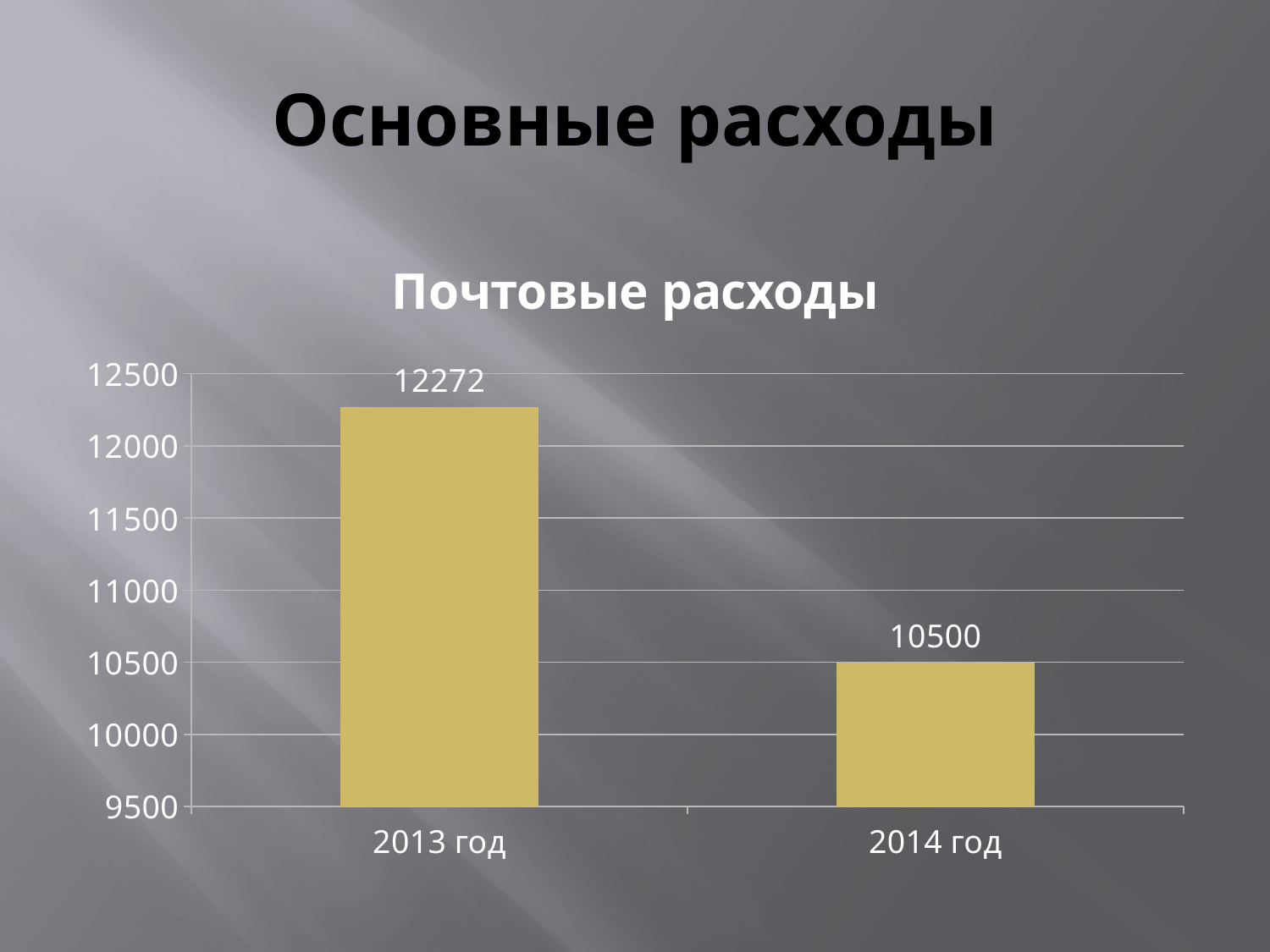
Which is larger, the value for 2013 год or for 2014 год? 2013 год How many categories are shown on the x axis? 2 Is the value for 2014 год greater or less than 11000? less What kind of chart is shown? bar chart Is the value for 2013 год greater or less than 12000? greater What is the value for 2013 год? 12272 What is the value for 2014 год? 10500 What is the title of the chart? Почтовые расходы Which year has the lowest value? 2014 год Which year has the highest value? 2013 год Do the values rise or fall from 2013 год to 2014 год? fall What is the difference between the values for 2013 год and 2014 год? 1772